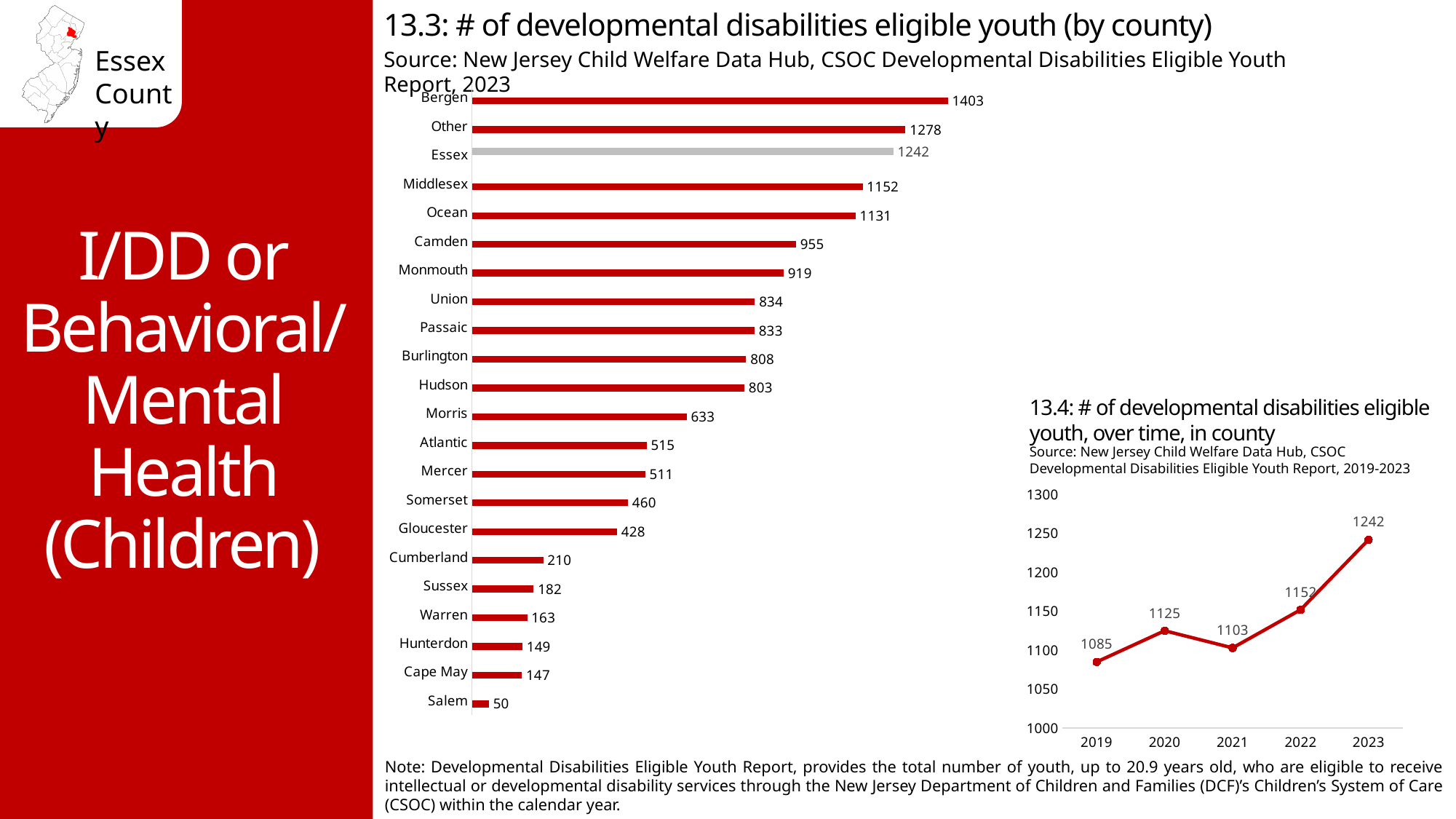
In chart 13.3 (by county), which county has the highest number of developmental disabilities eligible youth? Bergen In chart 13.3 (by county), how many categories are shown? 22 In chart 13.3 (by county), which is larger, the value for Middlesex or the value for Ocean? Middlesex In chart 13.3 (by county), what is the difference between Bergen and Essex? 161 What type of chart is chart 13.3 (by county)? Bar chart What type of chart is chart 13.4 (over time, in county)? Line chart In chart 13.3 (# of developmental disabilities eligible youth by county), what is the value for Essex? 1242 In chart 13.4 (over time, in county), which year has the highest value? 2023 In chart 13.3 (by county), which county has the lowest number of developmental disabilities eligible youth? Salem In chart 13.4 (over time, in county), what is the value for 2021? 1103 In chart 13.3 (by county), what is the value for Camden? 955 In chart 13.4 (over time, in county), what is the difference between the 2023 and 2019 values? 157